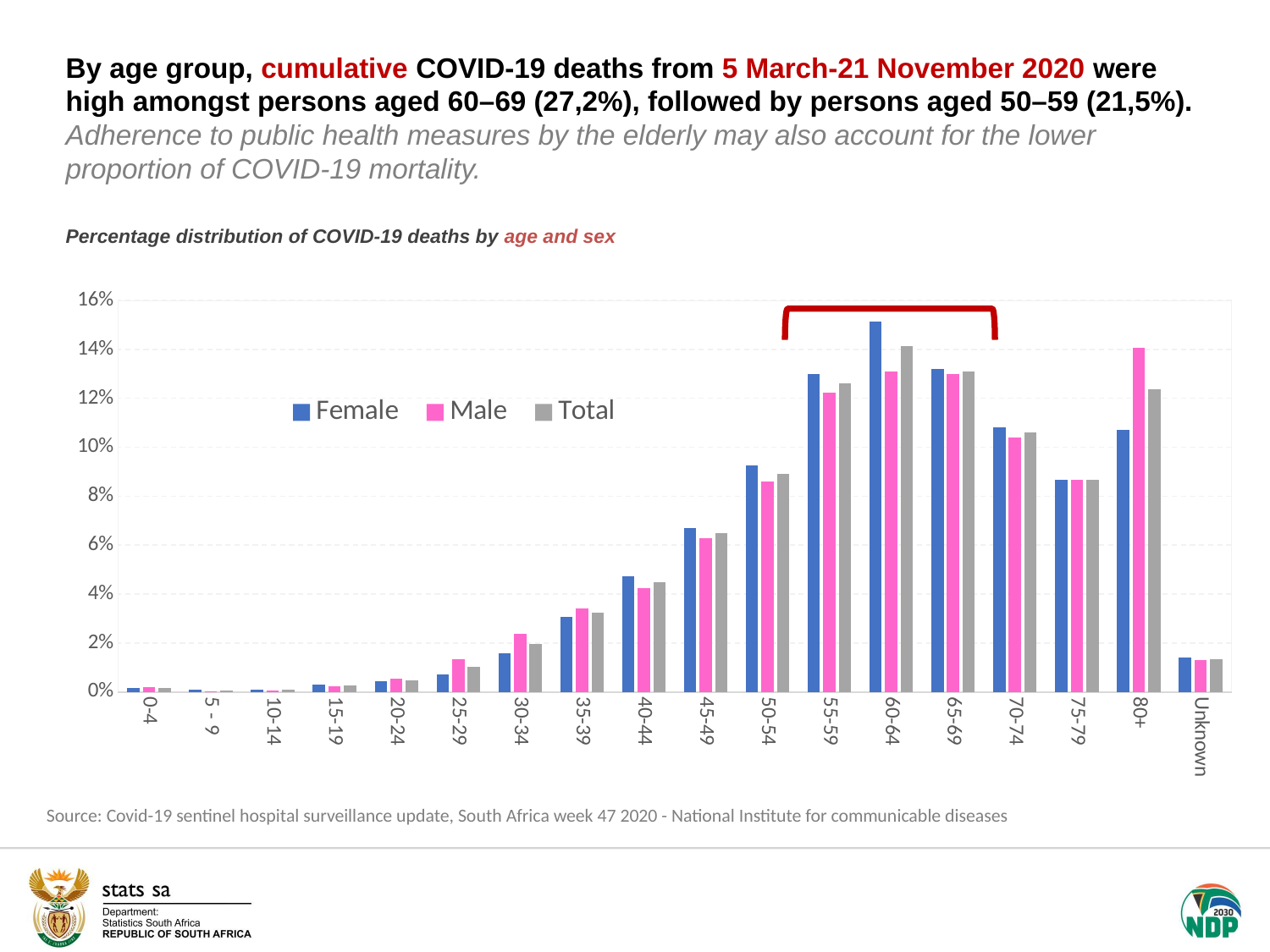
For the 60-64 age group, which is larger, the Female value or the Male value? Female Is the Male value for 80+ greater or less than 12%? greater Is the Female value for 60-64 greater or less than 14%? greater Which age group has the highest Total value? 60-64 How many series does the legend list? 3 Which age group has the highest Male value? 80+ How many age-group categories are shown on the x axis? 18 For the 80+ age group, which is larger, the Female value or the Male value? Male What is the title of the chart? Percentage distribution of COVID-19 deaths by age and sex What kind of chart is shown on the slide? bar chart Which age group has the highest Female value? 60-64 Is the Female value for 50-54 greater or less than 8%? greater